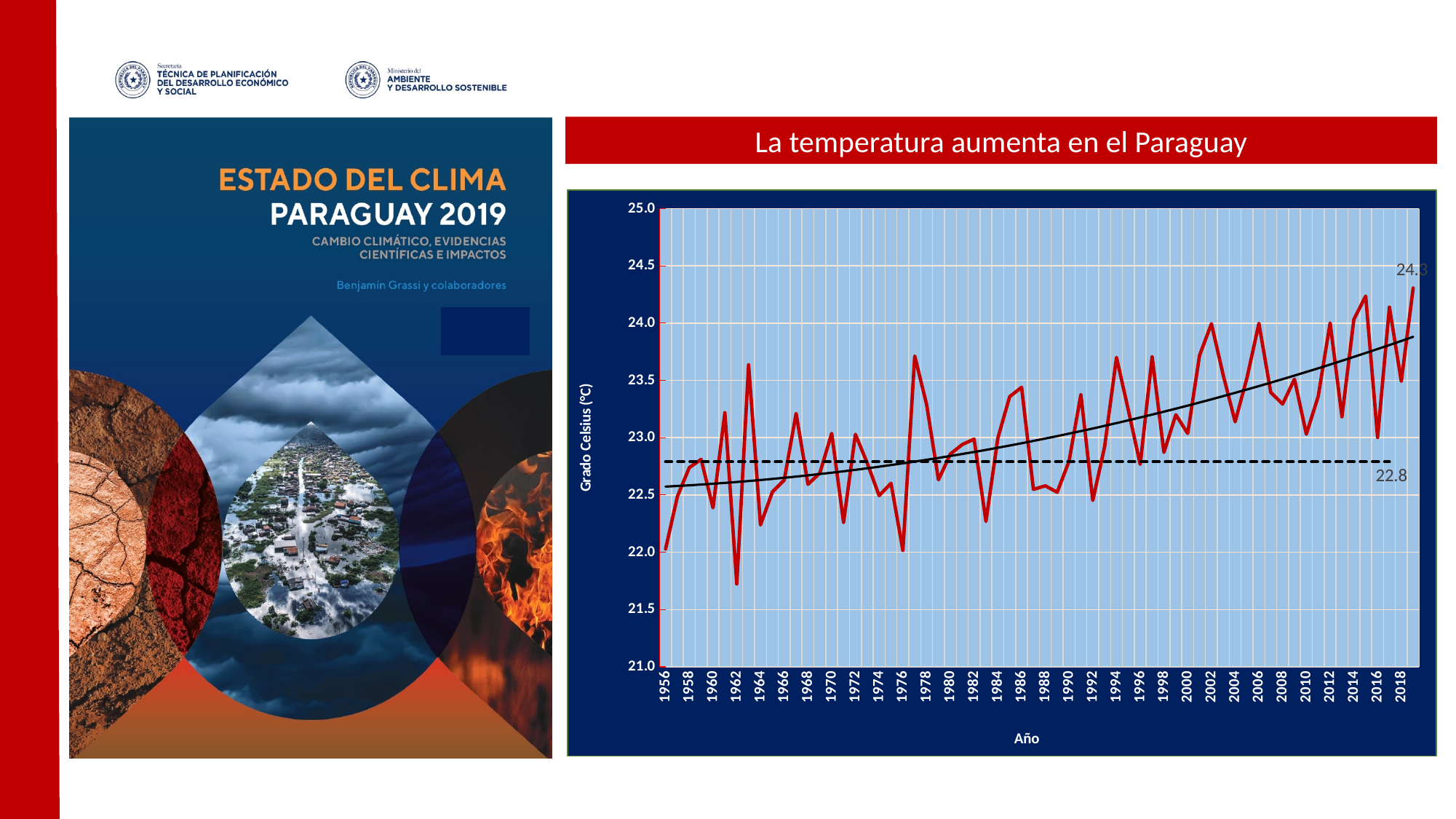
What kind of chart is shown on the right side of the slide? line chart What value is labelled on the horizontal dashed line? 22.8 Does the black trend line rise or fall from 1956 to 2018? rises What is the highest value shown on the vertical axis of the chart? 25.0 What is the title of the chart on the right side of the slide? La temperatura aumenta en el Paraguay Which year has the higher temperature value, 1962 or 2002? 2002 What is the label of the vertical axis of the chart? Grado Celsius (°C) Is the temperature value for 1962 greater or less than 22.0? less Is the temperature value for 1956 greater or less than 22.5? less What value is labelled at the end of the red temperature line? 24.3 What is the difference between the value labelled at the end of the red line (24.3) and the value of the dashed line (22.8)? 1.5 Is the temperature value for 2002 greater or less than 23.5? greater